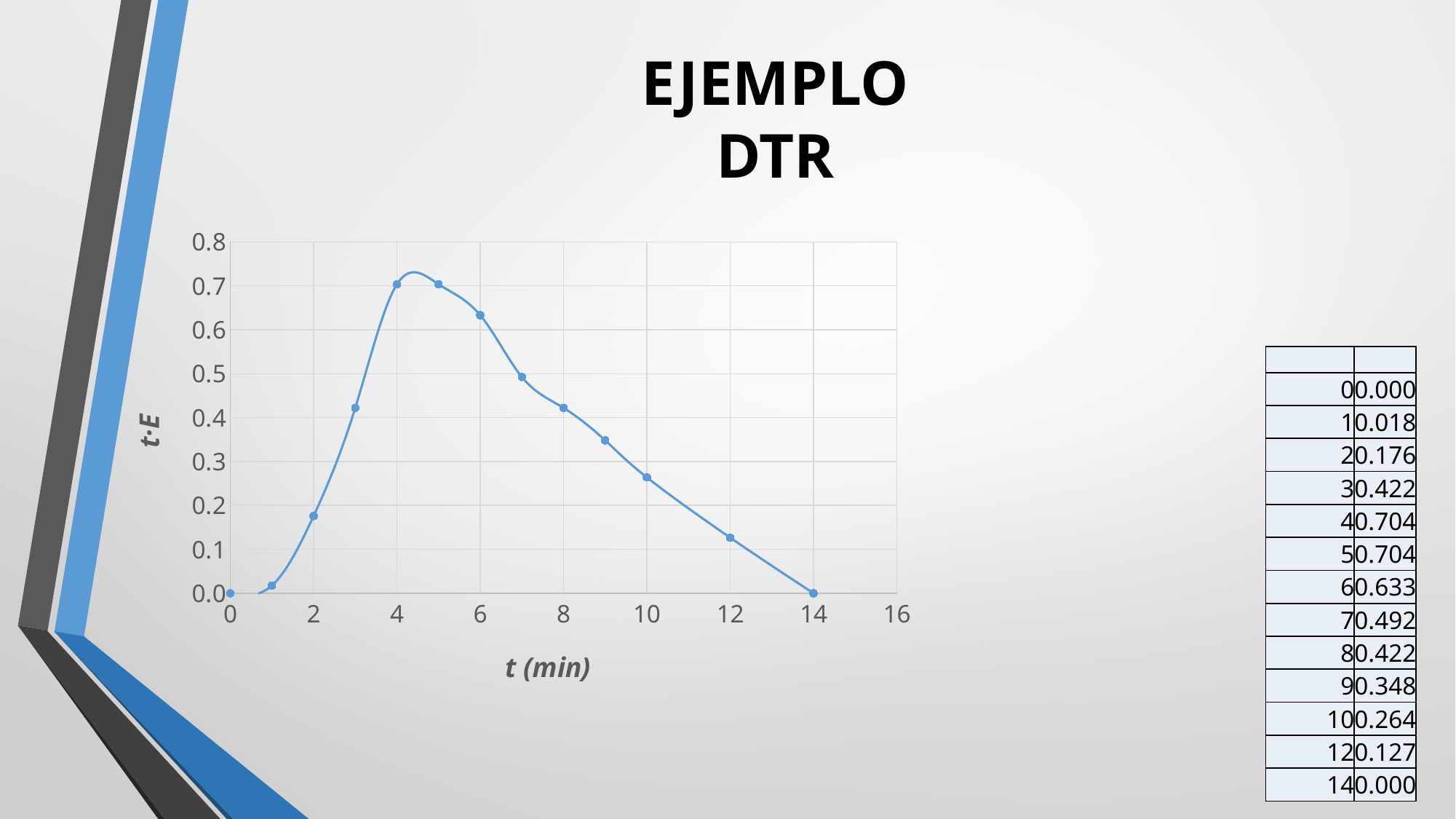
How does t·E change along the x axis from t = 5 min to t = 14 min? it falls According to the table on the slide, what is the value of t·E at t = 6 min? 0.633 How many data points are plotted on the chart? 13 What is the label of the y axis of the chart? t·E Which is larger, the value of t·E at t = 7 min or at t = 10 min? t = 7 min According to the table on the slide, what is the value of t·E at t = 12 min? 0.127 What kind of chart is shown on the slide? line chart Using the table values, what is the difference between t·E at t = 4 min and at t = 6 min? 0.071 What is the label of the x axis of the chart? t (min) Is the value of t·E at t = 6 min greater or less than 0.6? greater Is the value of t·E at t = 2 min greater or less than 0.2? less According to the table on the slide, what is the value of t·E at t = 3 min? 0.422